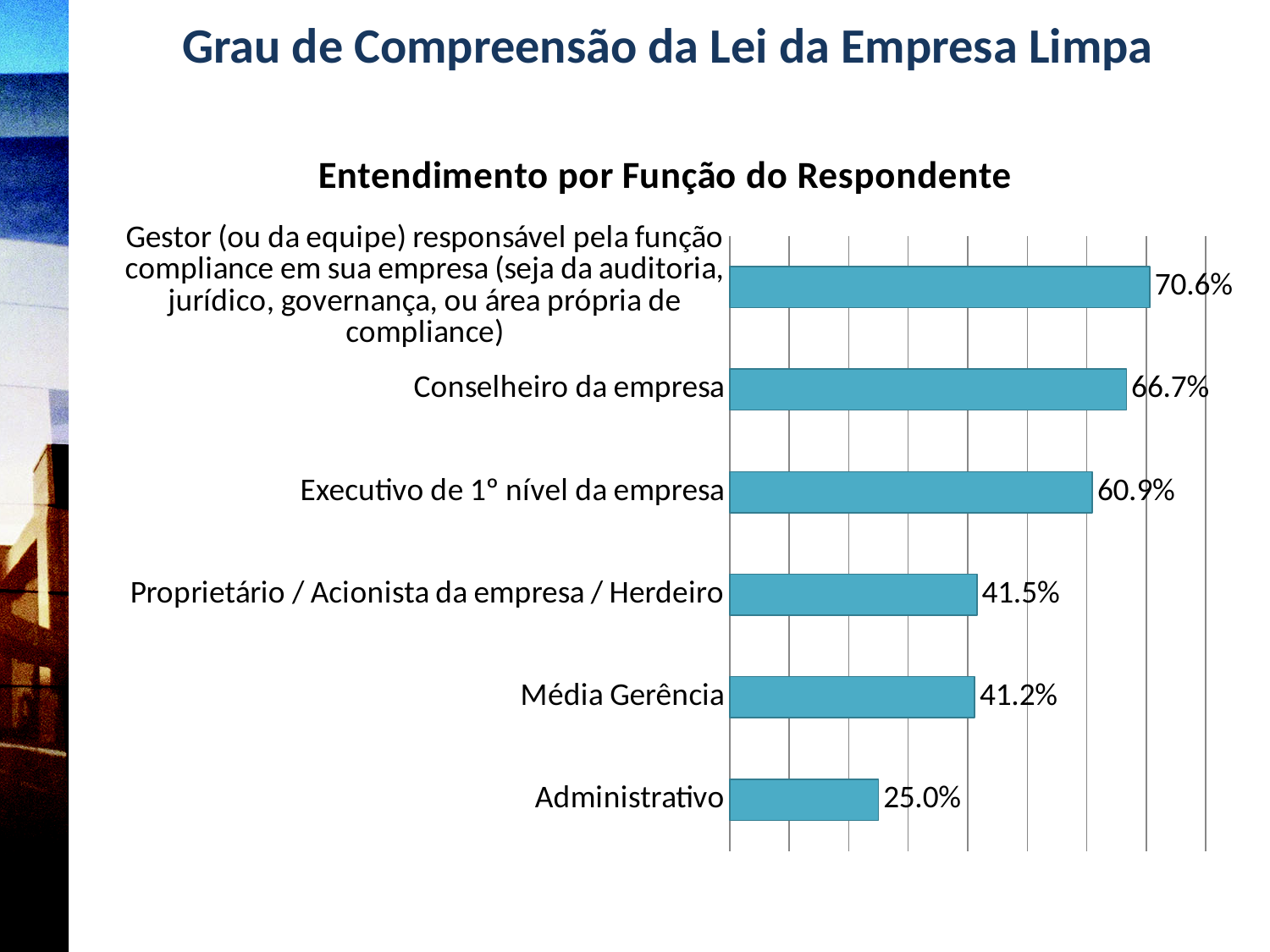
What is the value for Conselheiro da empresa? 66.7% What is the value for Executivo de 1º nível da empresa? 60.9% What is the value for Média Gerência? 41.2% Which is larger: the value for Executivo de 1º nível da empresa or the value for Conselheiro da empresa? Conselheiro da empresa Which category has the lowest value? Administrativo How many categories are shown in the chart? 6 What is the title of the chart? Entendimento por Função do Respondente What is the value for Administrativo? 25.0% What is the difference between the values for Conselheiro da empresa and Administrativo? 41.7% What is the difference between the values for Proprietário / Acionista da empresa / Herdeiro and Média Gerência? 0.3% Which category has the highest value? Gestor (ou da equipe) responsável pela função compliance em sua empresa What kind of chart is shown on the slide? Bar chart